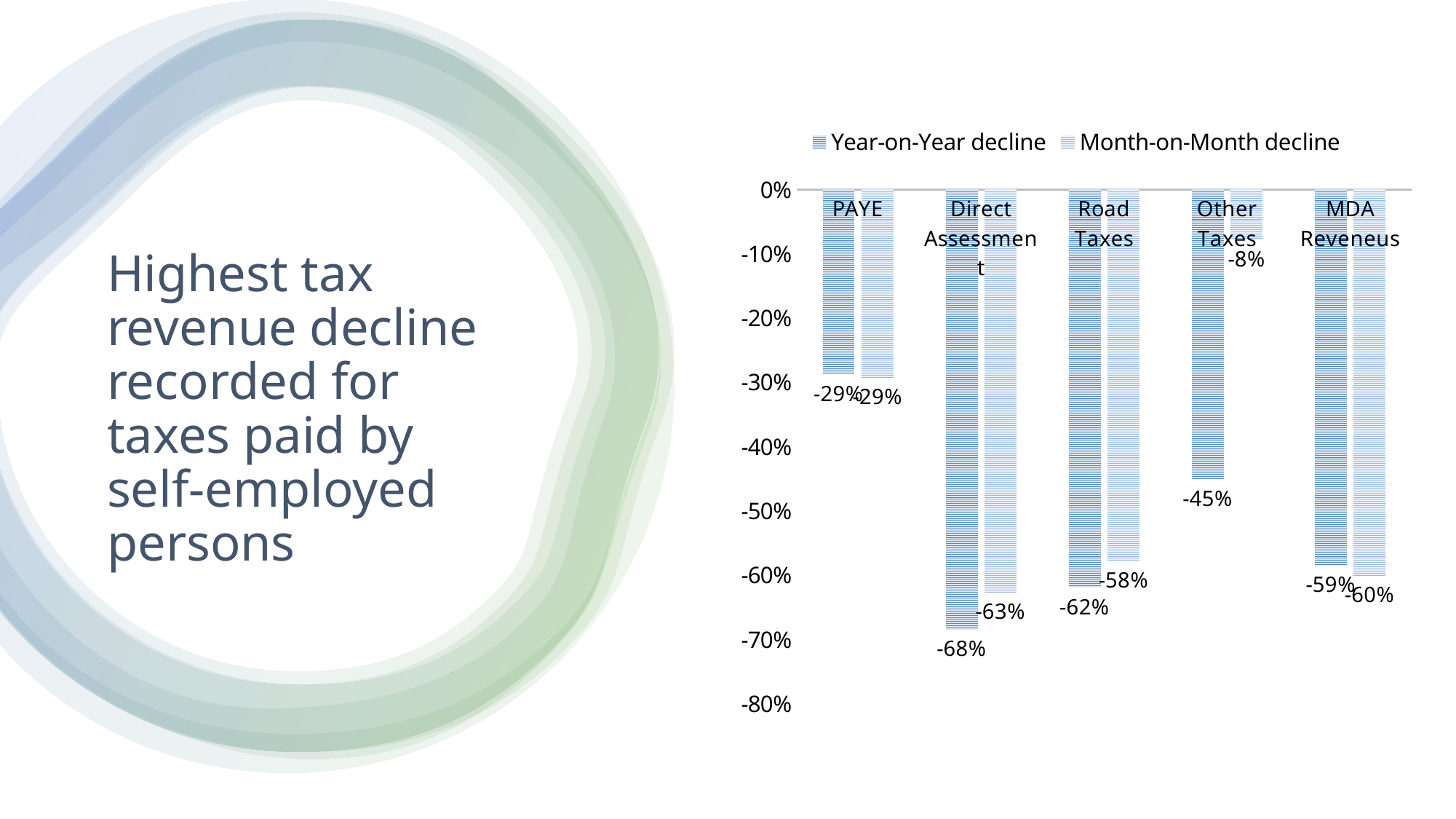
Which is larger in magnitude: the Year-on-Year decline for Direct Assessment or the Year-on-Year decline for PAYE? Direct Assessment What is the Month-on-Month decline for Other Taxes? -8% What is the Year-on-Year decline for Road Taxes? -62% How many tax categories are shown on the chart? 5 Which category has the largest Year-on-Year decline? Direct Assessment What are the two series named in the chart legend? Year-on-Year decline and Month-on-Month decline Which category has the smallest Month-on-Month decline? Other Taxes What is the Year-on-Year decline for Direct Assessment? -68% What is the Month-on-Month decline for MDA Revenues? -60% How many series does the chart legend list? 2 What kind of chart is shown on the slide? Bar chart What is the difference between the Year-on-Year decline and the Month-on-Month decline for Other Taxes? 37 percentage points